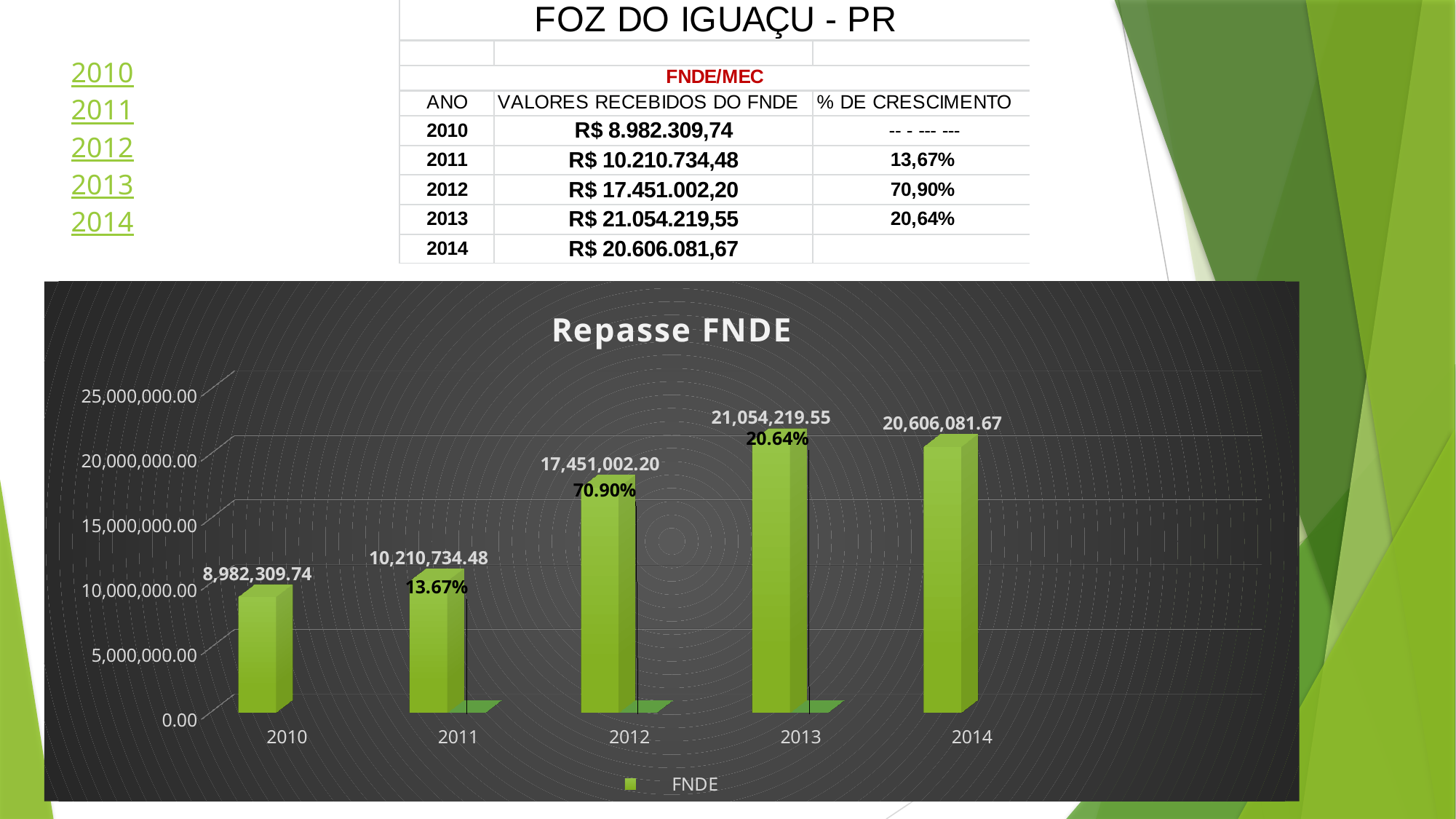
What is the difference between the 2013 and 2014 values in the Repasse FNDE chart? 448,137.88 Which year has the lowest value in the Repasse FNDE chart? 2010 What growth percentage is shown above the 2012 bar in the Repasse FNDE chart? 70.90% What kind of chart is Repasse FNDE? Bar chart Which year has the highest value in the Repasse FNDE chart? 2013 In the Repasse FNDE chart, which is larger, the value for 2011 or the value for 2012? 2012 What series name does the legend of the Repasse FNDE chart show? FNDE How many years are shown on the x axis of the Repasse FNDE chart? 5 What is the value for 2012 in the Repasse FNDE chart? 17,451,002.20 Is the value for 2014 in the Repasse FNDE chart greater or less than 20,000,000.00? greater What is the value for 2010 in the Repasse FNDE chart? 8,982,309.74 What is the difference between the 2011 and 2010 values in the Repasse FNDE chart? 1,228,424.74